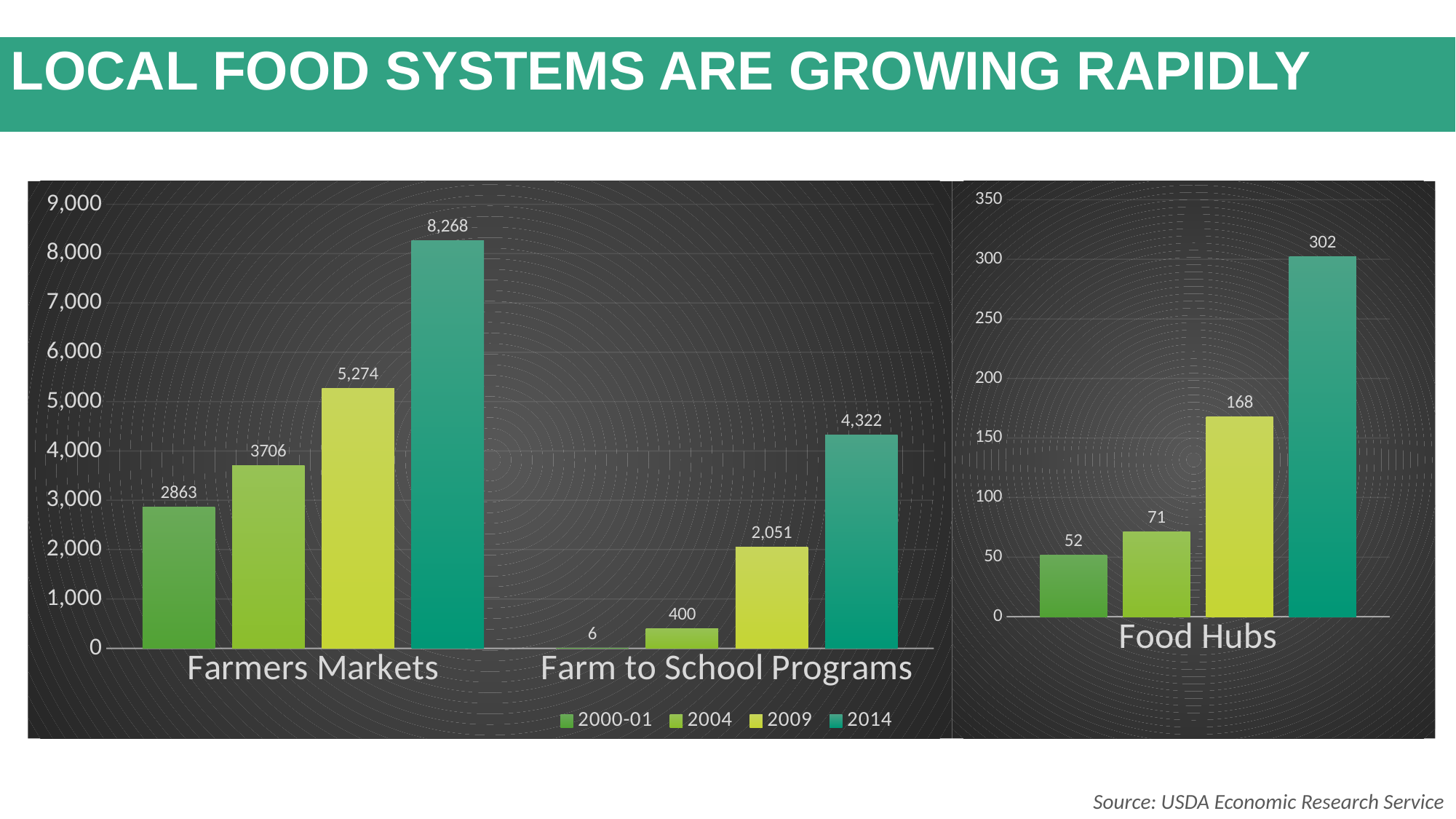
On the left chart, what is the value for Farmers Markets in 2014? 8,268 On the left chart, what is the difference between the Farmers Markets values for 2014 and 2009? 2,994 On the right chart, do the Food Hubs values rise or fall from 2000-01 to 2014? Rise On the right chart, what is the value for Food Hubs in 2014? 302 On the left chart, which year has the lowest value for Farm to School Programs? 2000-01 On the left chart, which is larger: Farm to School Programs in 2014 or Farmers Markets in 2004? Farm to School Programs in 2014 On the left chart, what is the value for Farm to School Programs in 2009? 2,051 On the right chart, what is the difference between the Food Hubs values for 2009 and 2004? 97 What kind of chart is the right chart showing Food Hubs? Bar chart On the left chart, what is the value for Farmers Markets in 2000-01? 2863 How many series does the legend on the left chart list? 4 What is the title of the slide? LOCAL FOOD SYSTEMS ARE GROWING RAPIDLY